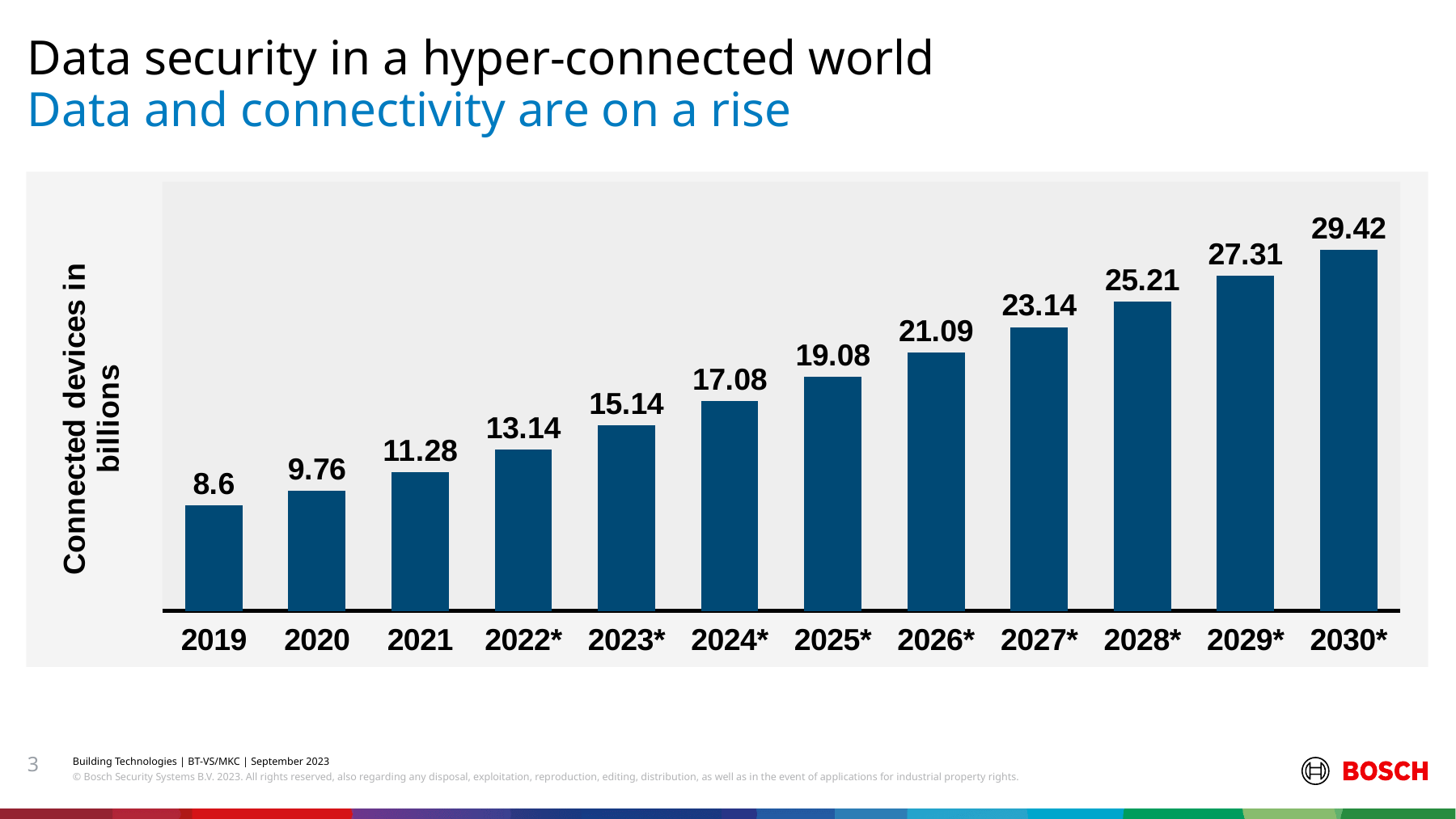
Do the values rise or fall from 2019 to 2030*? Rise Which year has the highest value? 2030* How many years are shown on the x axis? 12 What is the value for 2030*? 29.42 What kind of chart is this? Bar chart Which year has the lowest value? 2019 What is the label on the vertical axis? Connected devices in billions What is the value for 2025*? 19.08 What is the difference between the values for 2030* and 2019? 20.82 Which is larger, the value for 2023* or the value for 2027*? 2027* What is the difference between the values for 2021 and 2020? 1.52 What is the value for 2019? 8.6